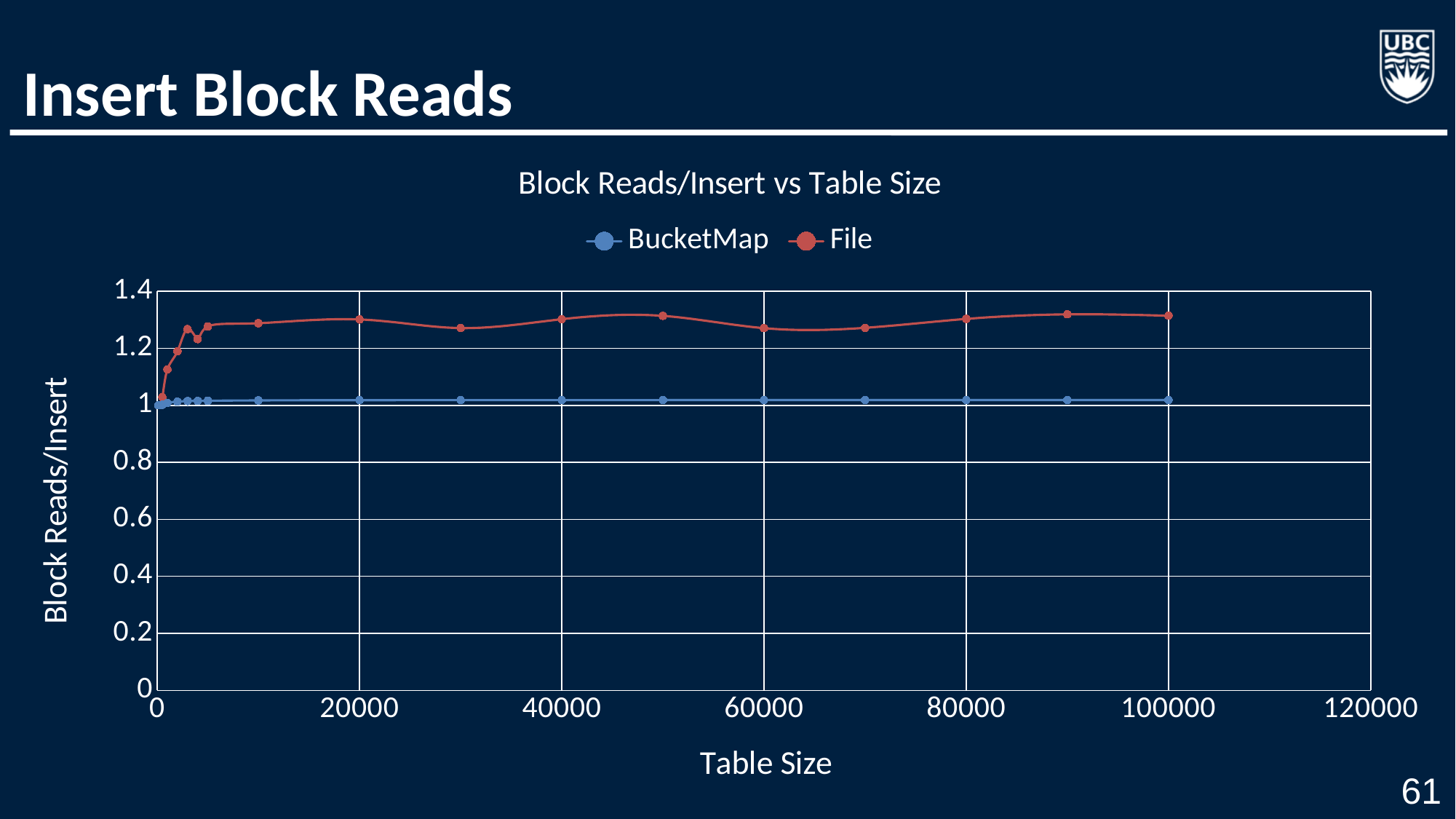
What kind of chart is shown on the slide? line chart What is the label of the x axis? Table Size Does the File series rise or fall as table size increases from 0 to about 5000? rise How many series does the legend list? 2 Is the File value at a table size of 100000 greater or less than 1.2? greater Is the BucketMap value at a table size of 100000 greater or less than 1.2? less Which series has the lower Block Reads/Insert across the whole range of table sizes? BucketMap Is the File value at a table size of 40000 greater or less than 1.2? greater At a table size of 100000, which series has the higher Block Reads/Insert, BucketMap or File? File Which series is drawn in red? File What is the title of the chart? Block Reads/Insert vs Table Size